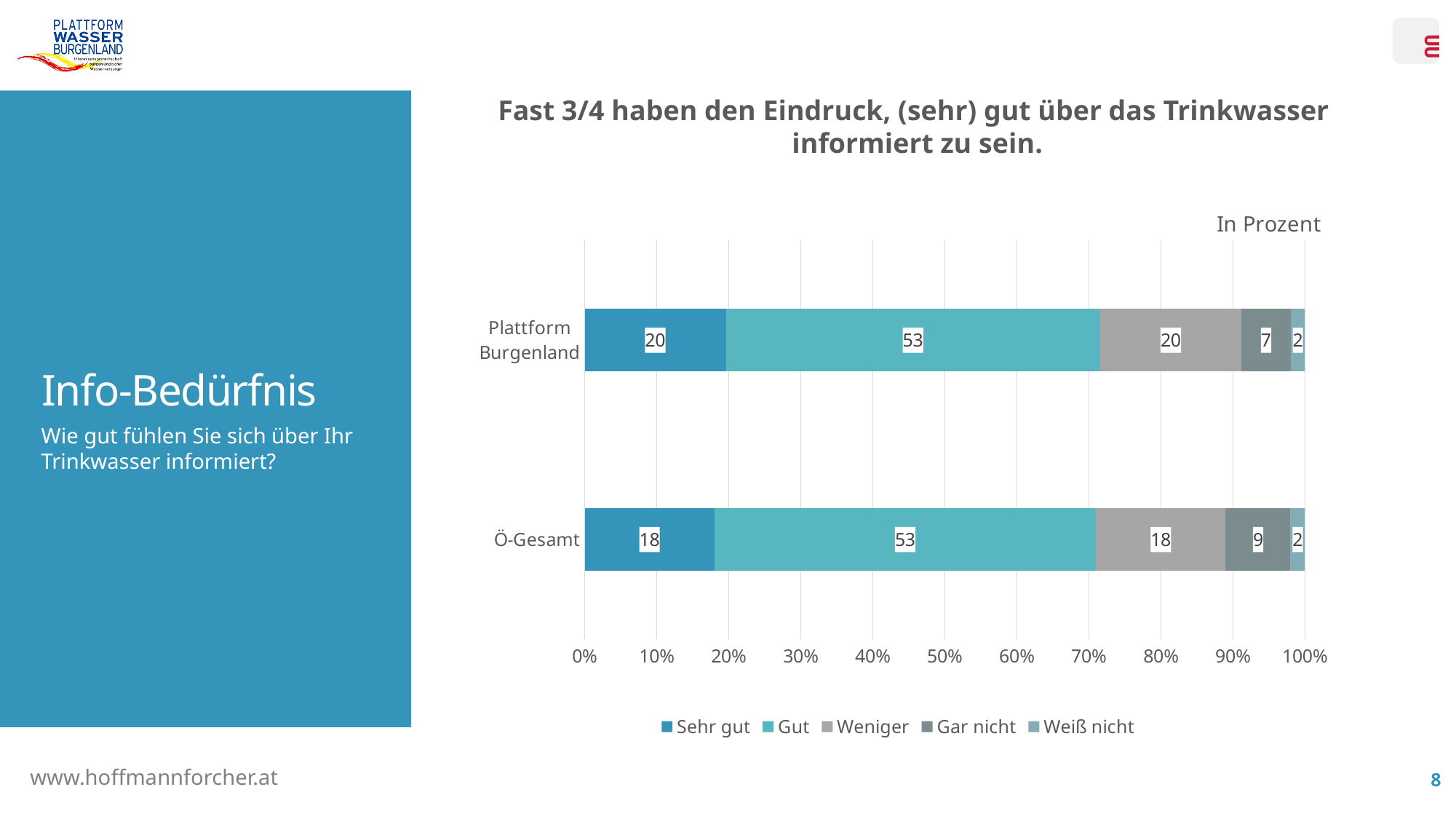
What is the value for "Gut" for Ö-Gesamt? 53 Which series has the highest value for Plattform Burgenland? Gut How many series does the legend list? 5 What is the difference between the "Sehr gut" values for Plattform Burgenland and Ö-Gesamt? 2 What is the combined value of "Sehr gut" and "Gut" for Plattform Burgenland? 73 What is the value for "Sehr gut" for Plattform Burgenland? 20 How many categories are shown on the y axis? 2 What kind of chart is shown on the slide? Stacked bar chart Which series has the lowest value for Ö-Gesamt? Weiß nicht What is the value for "Gar nicht" for Ö-Gesamt? 9 What is the value for "Weniger" for Plattform Burgenland? 20 Which category has the larger "Gar nicht" value, Plattform Burgenland or Ö-Gesamt? Ö-Gesamt